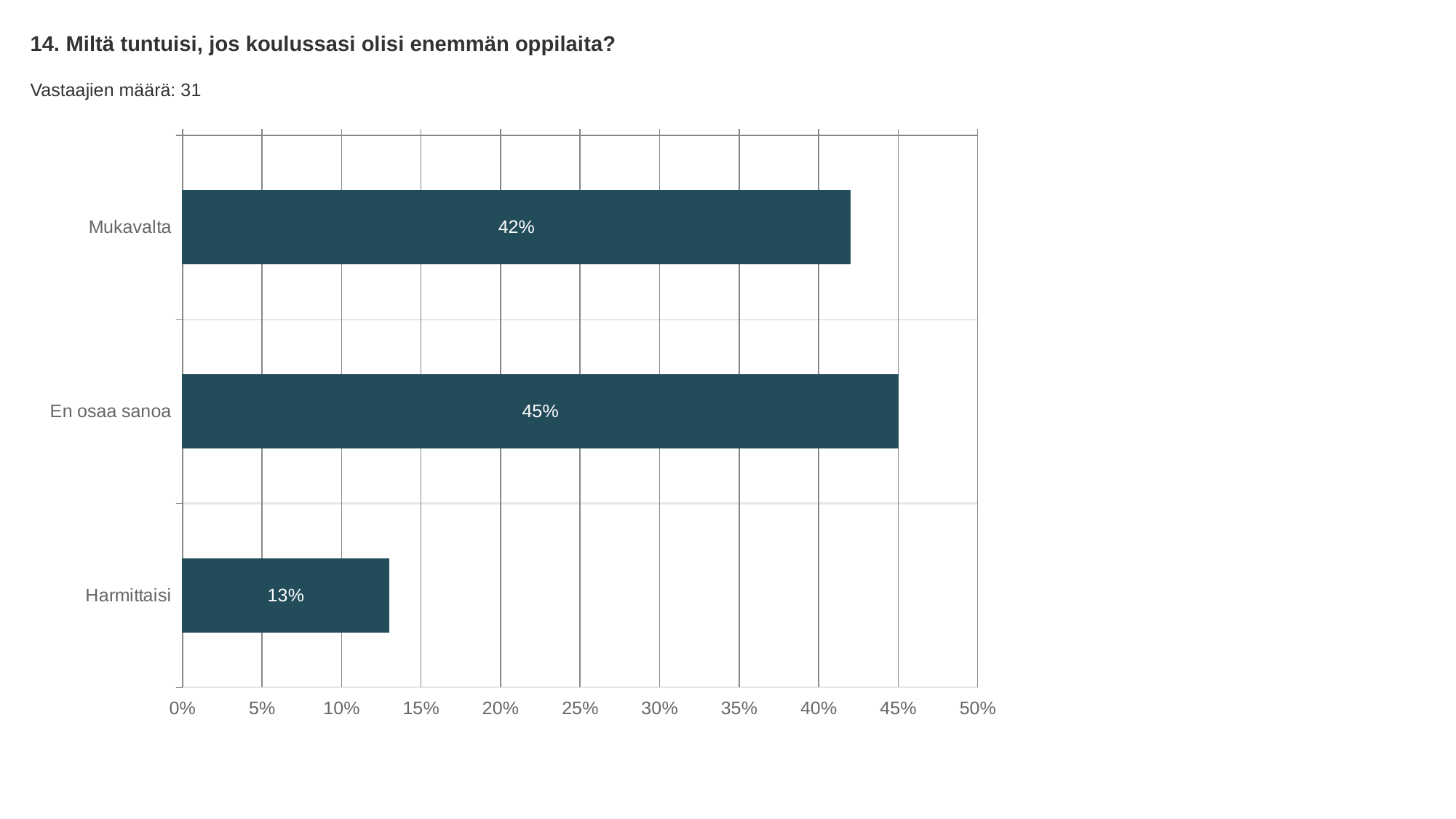
What is the difference between the values for Mukavalta and Harmittaisi? 29% What is the value for Harmittaisi? 13% What is the value for En osaa sanoa? 45% How many categories are shown in the chart? 3 What kind of chart is shown on the slide? bar chart What is the difference between the values for En osaa sanoa and Mukavalta? 3% What is the number of respondents (Vastaajien määrä) stated on the slide? 31 What is the value for Mukavalta? 42% Which is larger, the value for Mukavalta or the value for Harmittaisi? Mukavalta Is the value for Harmittaisi greater or less than 15%? less Which category has the highest value? En osaa sanoa Which category has the lowest value? Harmittaisi